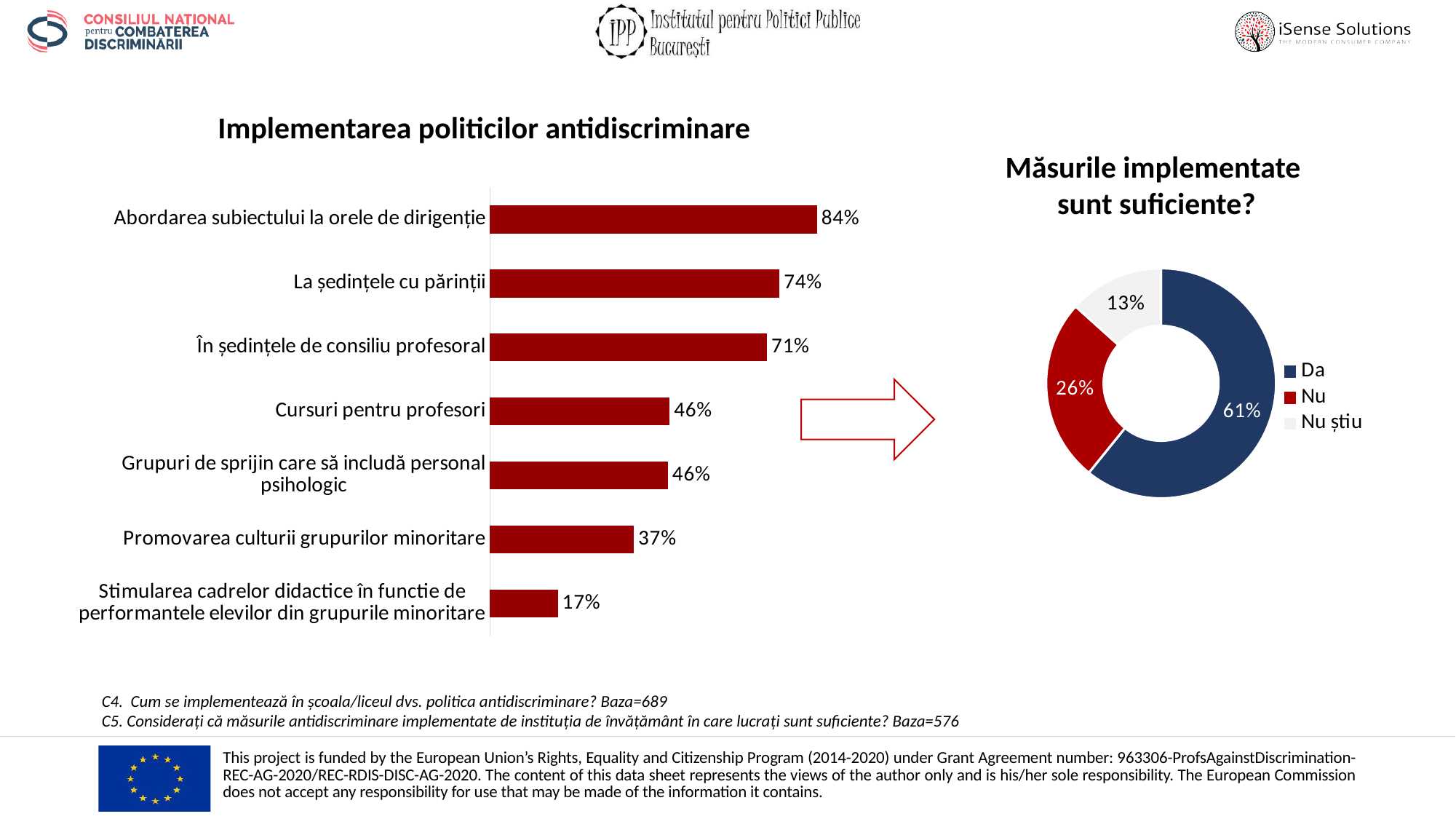
In the bar chart 'Implementarea politicilor antidiscriminare', what is the value for 'La ședințele cu părinții'? 74% In the bar chart 'Implementarea politicilor antidiscriminare', which category has the highest value? Abordarea subiectului la orele de dirigenție In the chart 'Măsurile implementate sunt suficiente?', which category has the largest share? Da How many entries does the legend of the chart 'Măsurile implementate sunt suficiente?' list? 3 How many categories are shown in the bar chart 'Implementarea politicilor antidiscriminare'? 7 In the bar chart 'Implementarea politicilor antidiscriminare', which is larger: 'Cursuri pentru profesori' or 'Promovarea culturii grupurilor minoritare'? Cursuri pentru profesori In the chart 'Măsurile implementate sunt suficiente?', what is the share for 'Nu'? 26% In the bar chart 'Implementarea politicilor antidiscriminare', what is the difference between 'Abordarea subiectului la orele de dirigenție' and 'În ședințele de consiliu profesoral'? 13% What kind of chart is 'Implementarea politicilor antidiscriminare'? Bar chart In the bar chart 'Implementarea politicilor antidiscriminare', which category has the lowest value? Stimularea cadrelor didactice în functie de performantele elevilor din grupurile minoritare In the chart 'Măsurile implementate sunt suficiente?', what colour is the 'Da' segment? Dark blue In the bar chart 'Implementarea politicilor antidiscriminare', what is the value for 'Promovarea culturii grupurilor minoritare'? 37%